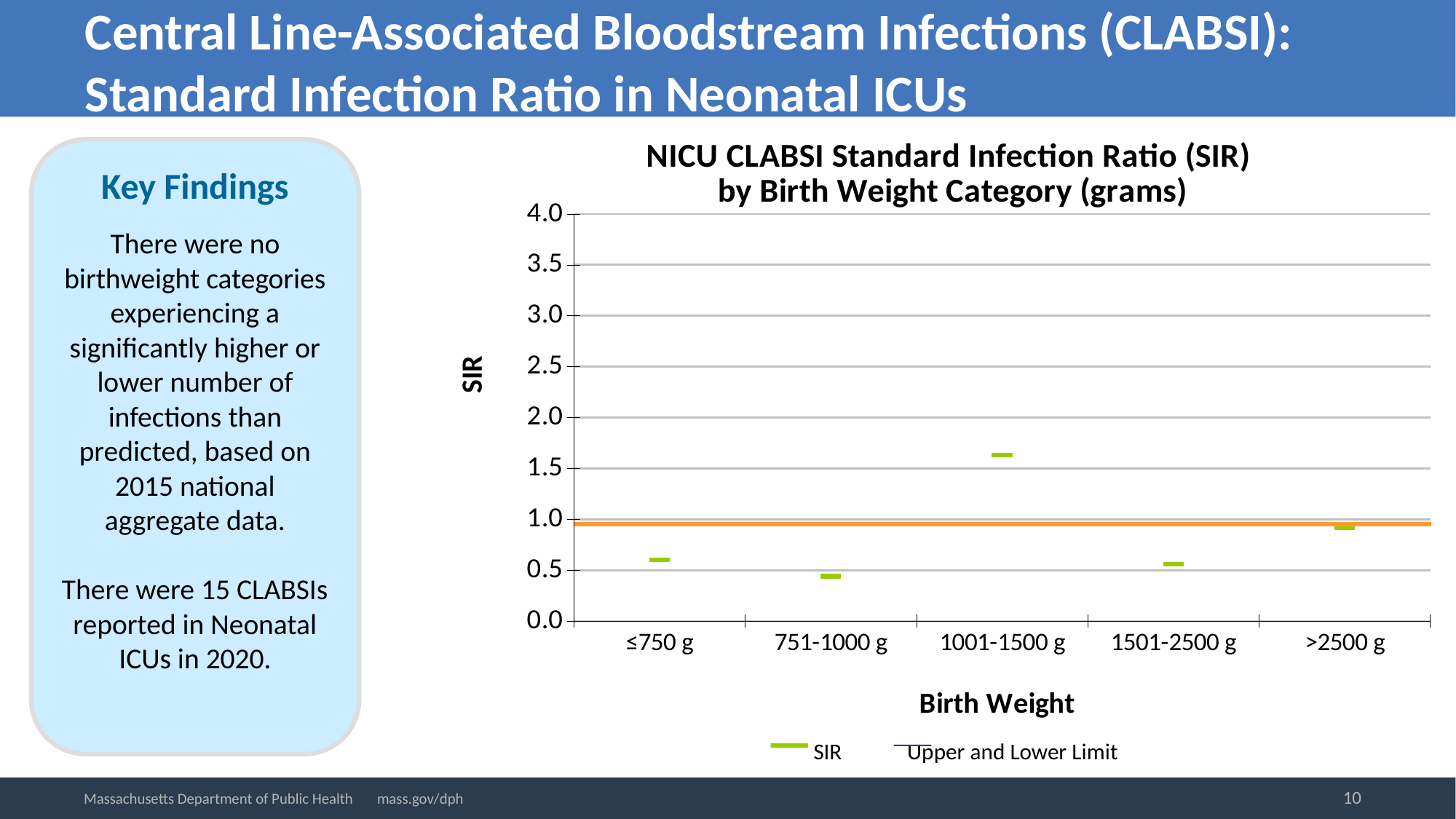
What is the label on the y axis of the chart? SIR Is the SIR for >2500 g greater or less than 1.0? less Which birth weight category has the highest SIR? 1001-1500 g Is the SIR for 751-1000 g greater or less than 0.5? less Which has a higher SIR, >2500 g or 751-1000 g? >2500 g How many birth weight categories are shown on the x axis? 5 Is the SIR for 1501-2500 g greater or less than 1.0? less Which birth weight category has the lowest SIR? 751-1000 g Which has a higher SIR, ≤750 g or 1001-1500 g? 1001-1500 g How many series does the legend list? 2